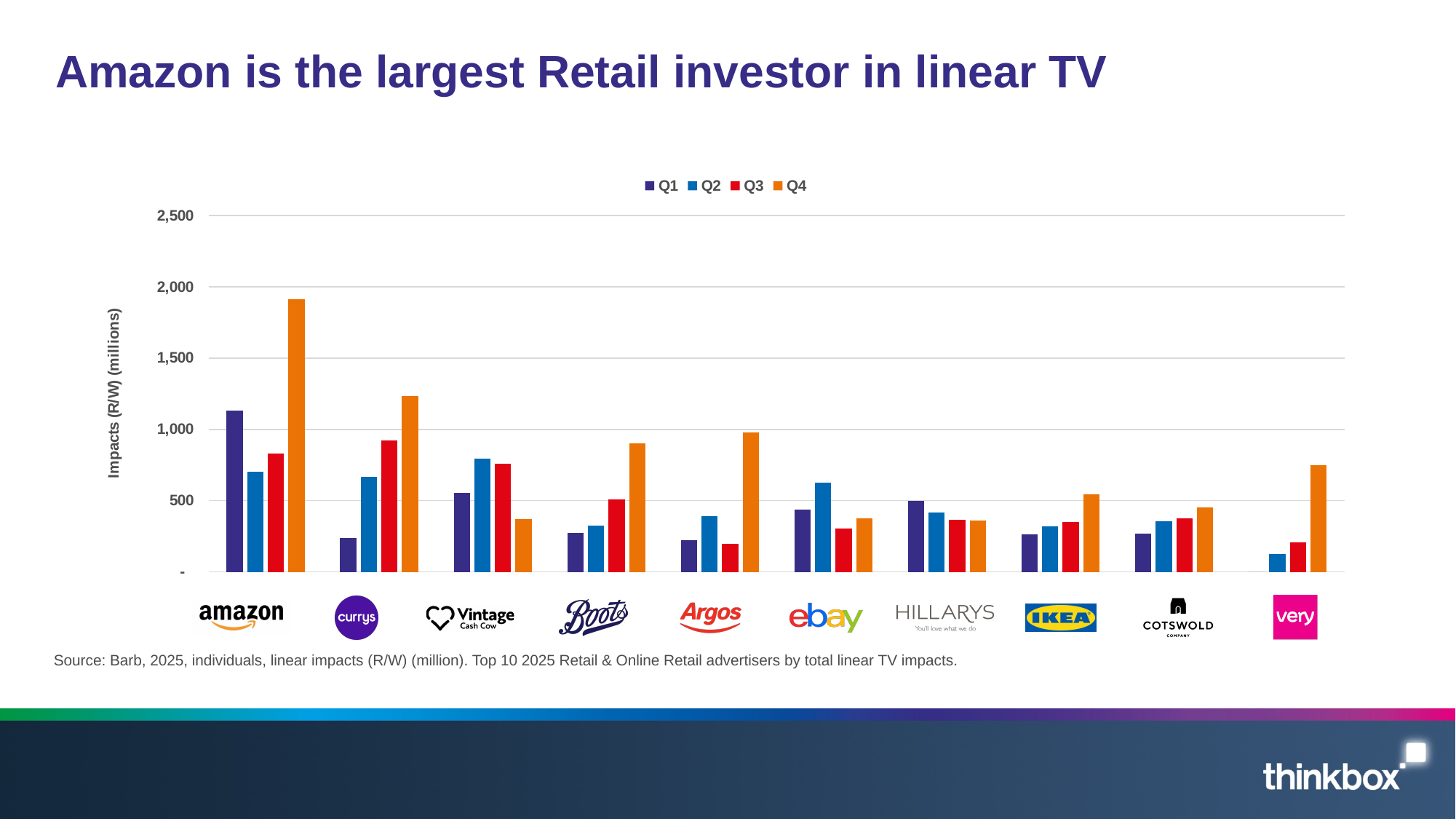
How many series does the legend list? 4 How many retailers are shown along the x axis? 10 Is the Q4 value for Vintage Cash Cow greater or less than 500? less For Amazon, which is larger: the Q1 value or the Q2 value? Q1 For eBay, which quarter has the highest value? Q2 Is the Q4 value for Currys greater or less than 1,000? greater What is the title of the y axis? Impacts (R/W) (millions) For Argos, which is larger: the Q4 value or the Q1 value? Q4 Is the Q4 value for Amazon greater or less than 1,500? greater What kind of chart is shown on the slide? bar chart Which retailer has the highest Q4 bar? Amazon